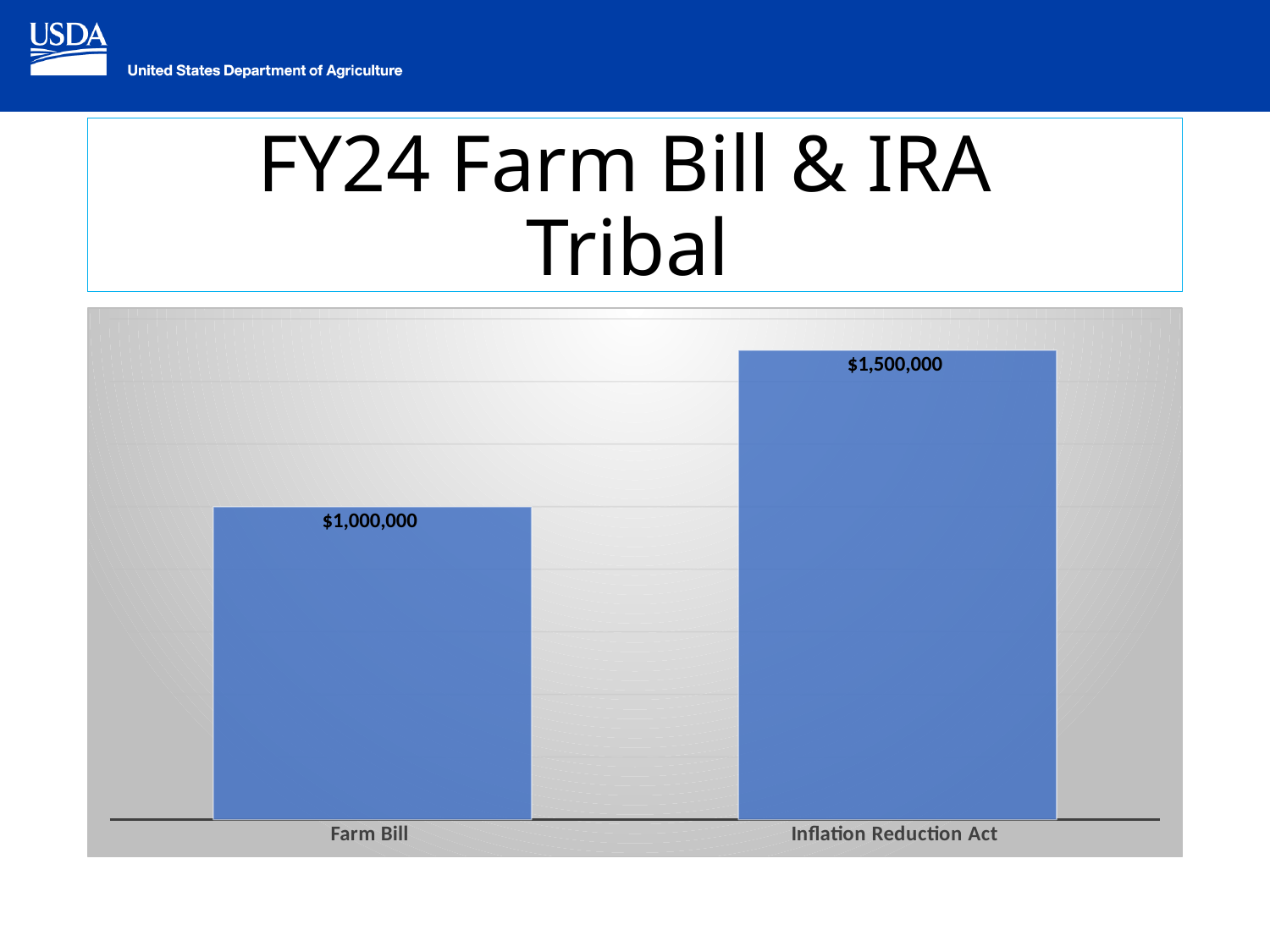
What is the total of the two bars in the chart? $2,500,000 What is the value for Farm Bill? $1,000,000 What is the value for Inflation Reduction Act? $1,500,000 How many categories are shown in the chart? 2 What colour are the bars in the chart? Blue What is the difference between the Inflation Reduction Act value and the Farm Bill value? $500,000 Do the values rise or fall from Farm Bill to Inflation Reduction Act? Rise What kind of chart is shown on the slide? Bar chart Which is larger, the value for Farm Bill or the value for Inflation Reduction Act? Inflation Reduction Act Which category has the highest value? Inflation Reduction Act What is the title of the slide containing the chart? FY24 Farm Bill & IRA Tribal Which category has the lowest value? Farm Bill